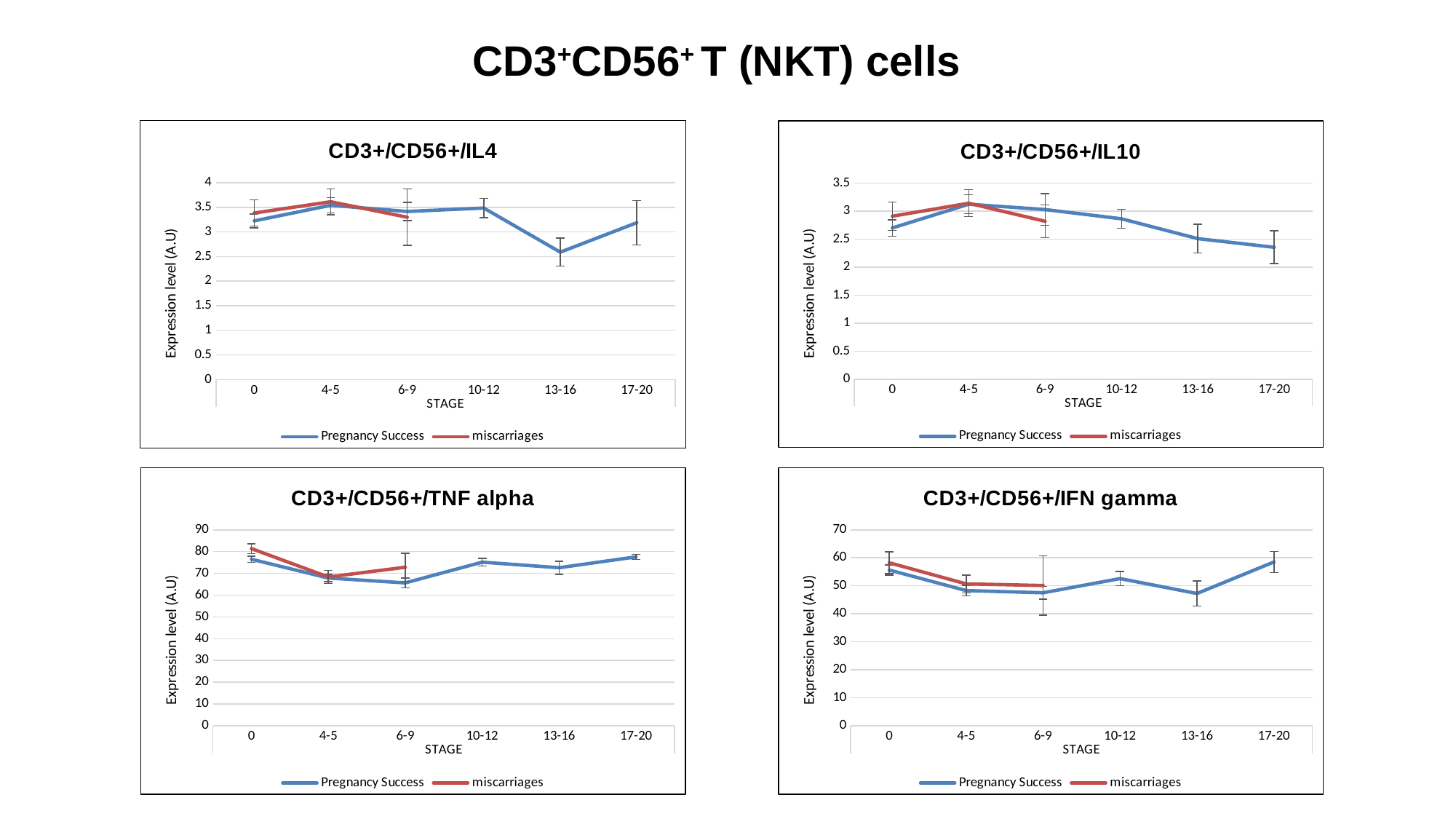
In the CD3+/CD56+/IL4 chart, is the Pregnancy Success value at stage 13-16 greater or less than 3? less In the CD3+/CD56+/IFN gamma chart, is the Pregnancy Success value at stage 17-20 greater or less than 50? greater In the CD3+/CD56+/IL10 chart, is the Pregnancy Success value at stage 17-20 greater or less than 2.5? less How many series does the legend of the CD3+/CD56+/IL10 chart list? 2 What colour is the miscarriages line in the CD3+/CD56+/IFN gamma chart? red In the CD3+/CD56+/IL4 chart, at which stage is the Pregnancy Success value lowest? 13-16 In the CD3+/CD56+/TNF alpha chart, at stage 0, which series has the higher value, Pregnancy Success or miscarriages? miscarriages How many stages are shown on the x axis of the CD3+/CD56+/TNF alpha chart? 6 In the CD3+/CD56+/IL10 chart, does the Pregnancy Success line rise or fall from stage 4-5 to stage 17-20? fall In the CD3+/CD56+/IL4 chart, how many stages have a plotted value for the miscarriages series? 3 What kind of chart is the CD3+/CD56+/IL4 chart? line chart